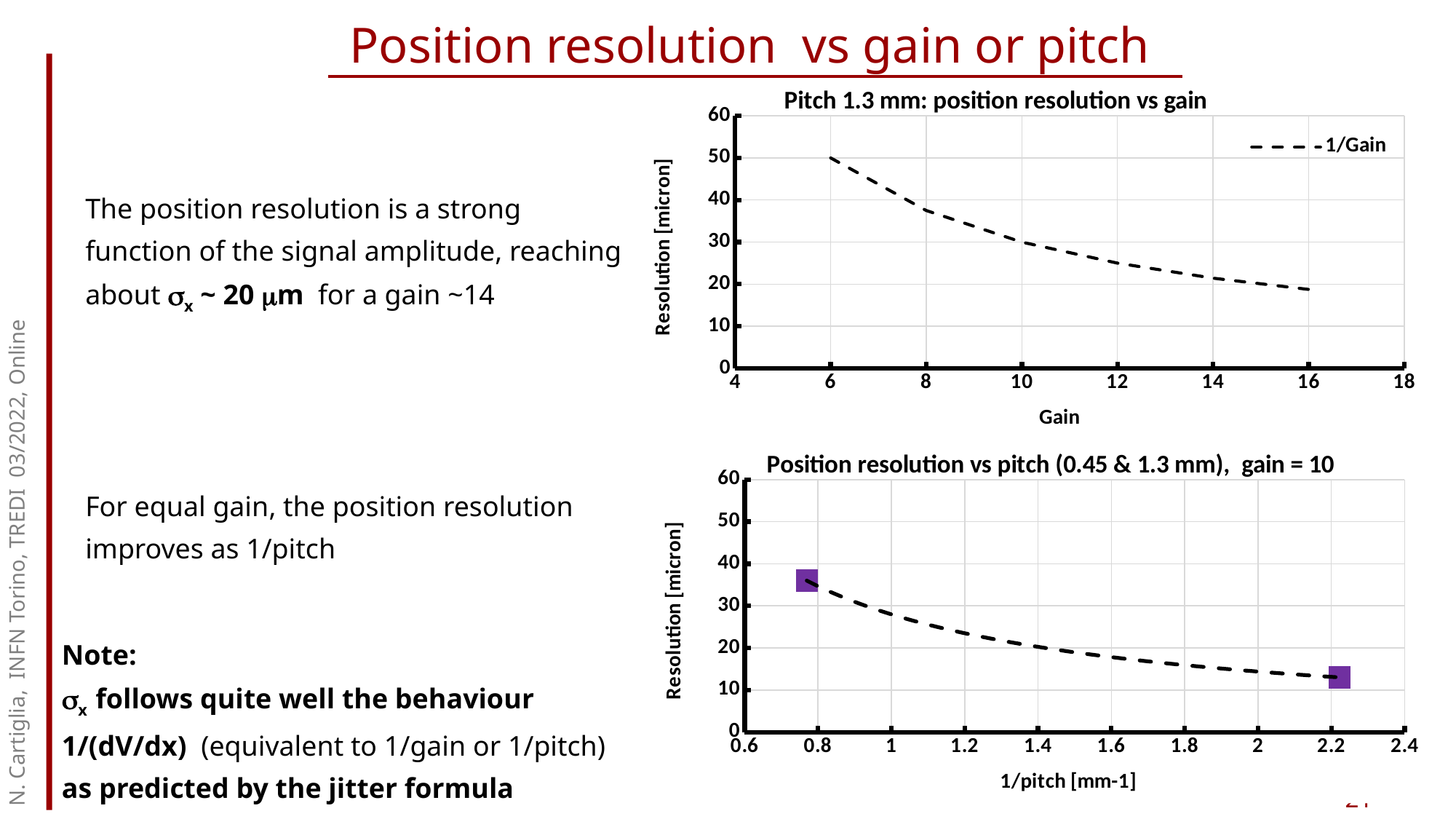
In the top chart 'Pitch 1.3 mm: position resolution vs gain', what is the legend entry for the dashed line? 1/Gain In the top chart 'Pitch 1.3 mm: position resolution vs gain', how many series does the legend list? 1 In the bottom chart 'Position resolution vs pitch (0.45 & 1.3 mm), gain = 10', how many purple square data points are plotted? 2 In the bottom chart 'Position resolution vs pitch (0.45 & 1.3 mm), gain = 10', is the resolution of the purple point near 1/pitch = 2.2 greater or less than 20? less In the top chart 'Pitch 1.3 mm: position resolution vs gain', what is the x-axis label? Gain In the top chart 'Pitch 1.3 mm: position resolution vs gain', does the resolution rise or fall as gain increases? fall In the bottom chart 'Position resolution vs pitch (0.45 & 1.3 mm), gain = 10', is the resolution of the purple point near 1/pitch = 0.8 greater or less than 30? greater In the top chart 'Pitch 1.3 mm: position resolution vs gain', is the resolution at gain 16 greater or less than 20? less In the bottom chart 'Position resolution vs pitch (0.45 & 1.3 mm), gain = 10', does the resolution rise or fall as 1/pitch increases? fall In the bottom chart 'Position resolution vs pitch (0.45 & 1.3 mm), gain = 10', which purple point has the higher resolution, the one near 1/pitch = 0.8 or the one near 1/pitch = 2.2? the one near 1/pitch = 0.8 In the top chart 'Pitch 1.3 mm: position resolution vs gain', what kind of chart is shown? line chart